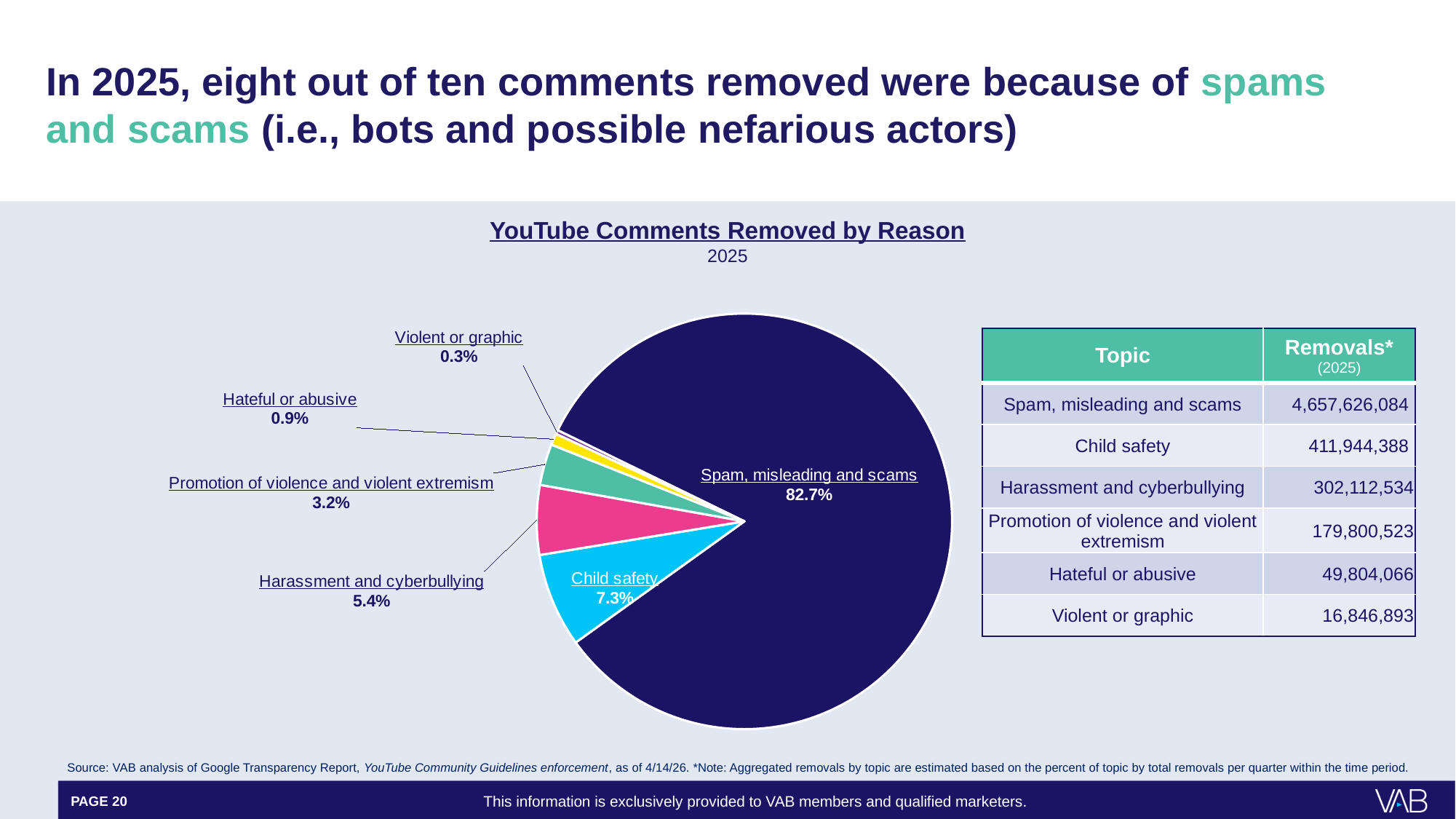
What share of YouTube comments removed in 2025 was for Spam, misleading and scams? 82.7% Which reason accounts for the largest slice of the pie? Spam, misleading and scams What kind of chart is shown on the slide? Pie chart What is the title of the pie chart? YouTube Comments Removed by Reason What is the difference in percentage points between Child safety and Harassment and cyberbullying? 1.9 percentage points Which reason accounts for the smallest slice of the pie? Violent or graphic Which is larger: the share for Promotion of violence and violent extremism or the share for Hateful or abusive? Promotion of violence and violent extremism What percentage of removed comments was for Violent or graphic? 0.3% What percentage of removed comments was for Child safety? 7.3% How many slices does the pie chart have? 6 What percentage of removed comments was for Harassment and cyberbullying? 5.4% What year does the pie chart cover? 2025